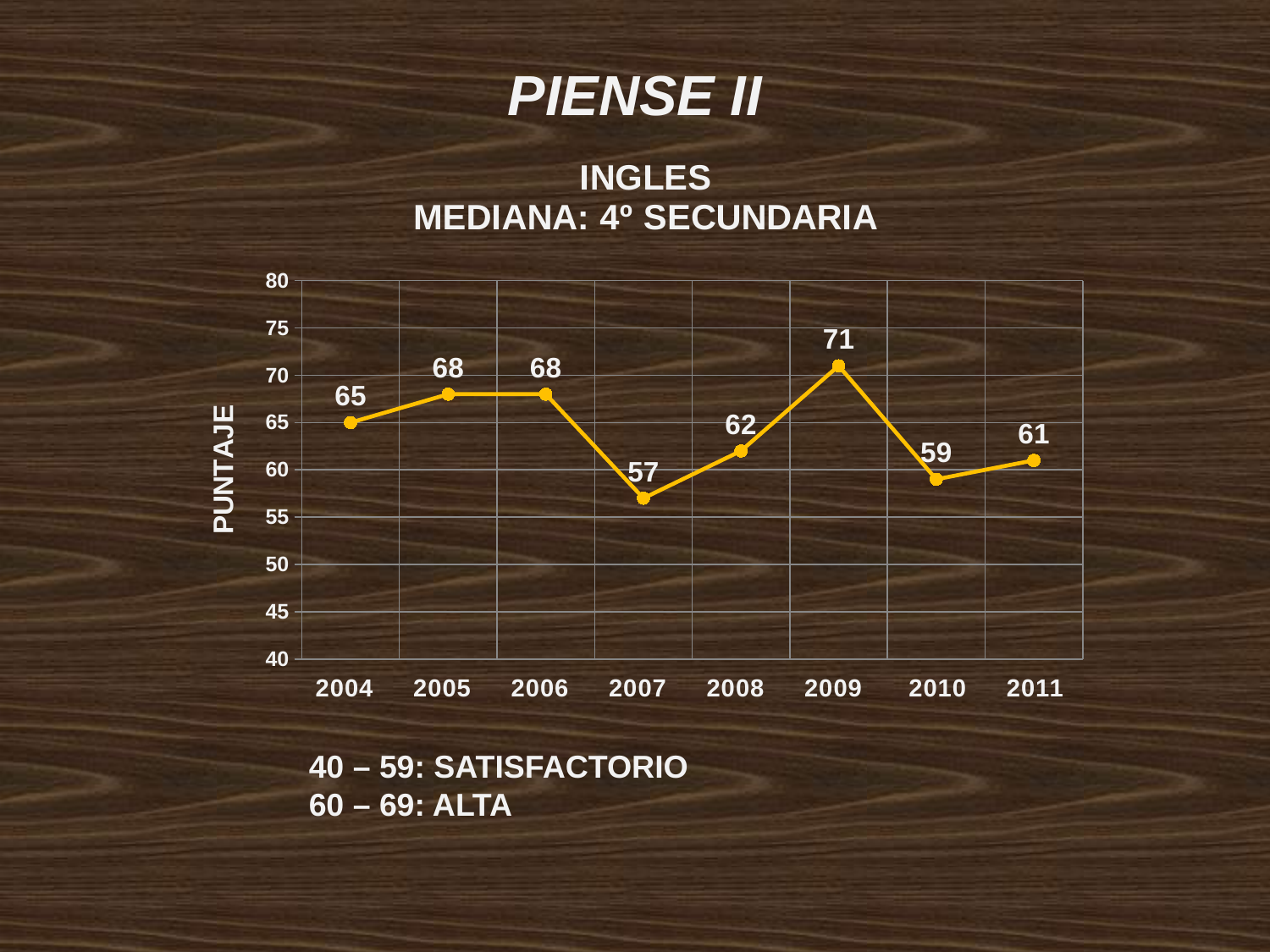
What is the PUNTAJE value for 2007? 57 What is the PUNTAJE value for 2009? 71 What is the difference between the PUNTAJE values for 2009 and 2007? 14 How many years are plotted on the chart? 8 What kind of chart is shown on the slide? line chart Is the PUNTAJE value for 2010 greater or less than 60? less Which year has the highest PUNTAJE? 2009 Which year has a higher PUNTAJE, 2008 or 2010? 2008 What is the difference between the PUNTAJE values for 2006 and 2007? 11 What is the PUNTAJE value for 2004? 65 Which year has the lowest PUNTAJE? 2007 What is the label of the vertical axis? PUNTAJE